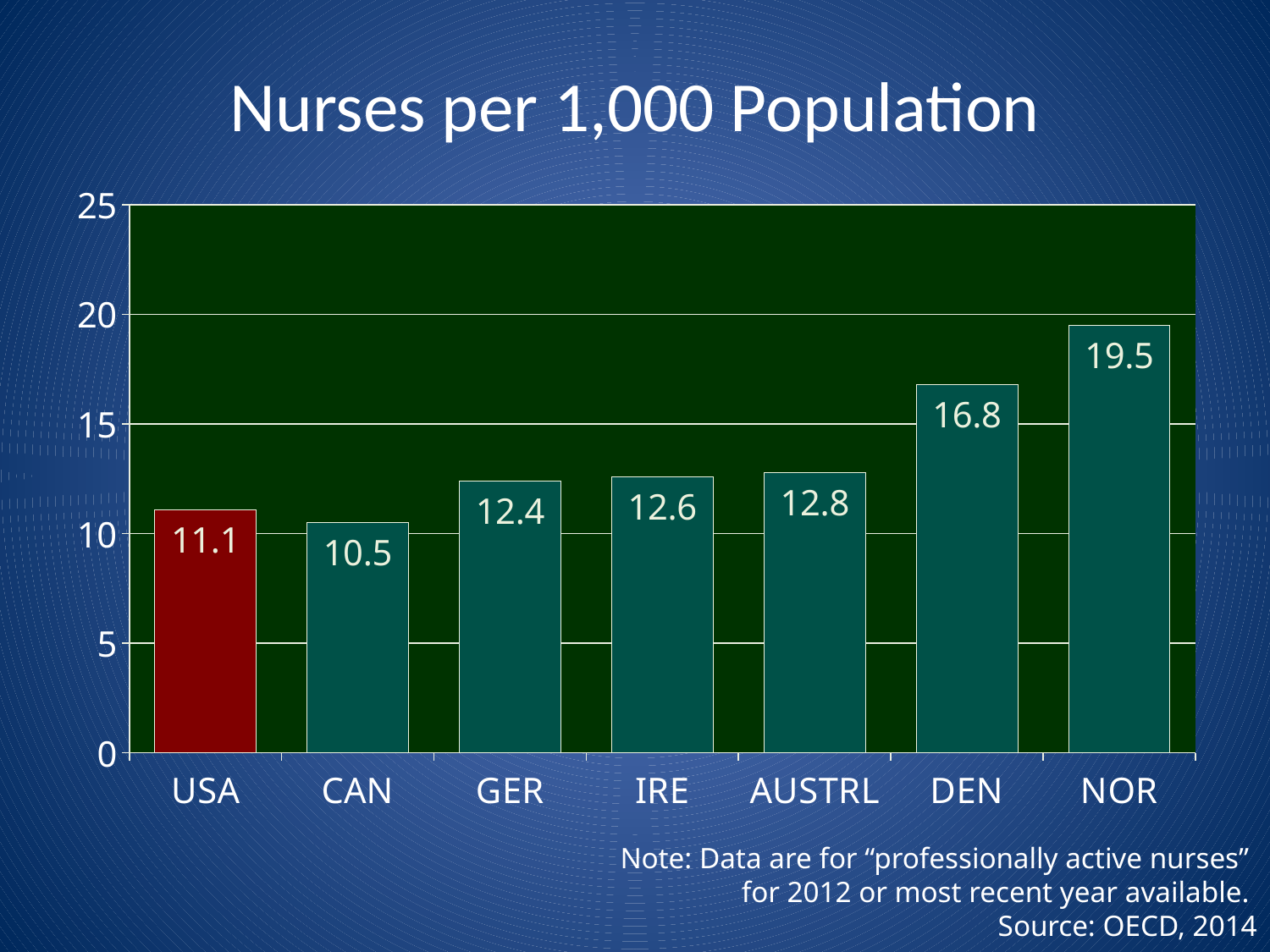
How many countries are shown in the chart? 7 Which is larger, the value for GER or the value for AUSTRL? AUSTRL Which country's bar is coloured red rather than teal? USA What is the value for DEN? 16.8 What is the difference between the values for NOR and USA? 8.4 What is the value for CAN? 10.5 Which country has the highest number of nurses per 1,000 population? NOR What is the title of the chart? Nurses per 1,000 Population What is the value for USA? 11.1 Is the value for DEN greater or less than 15? greater Which country has the lowest number of nurses per 1,000 population? CAN What kind of chart is shown on the slide? bar chart